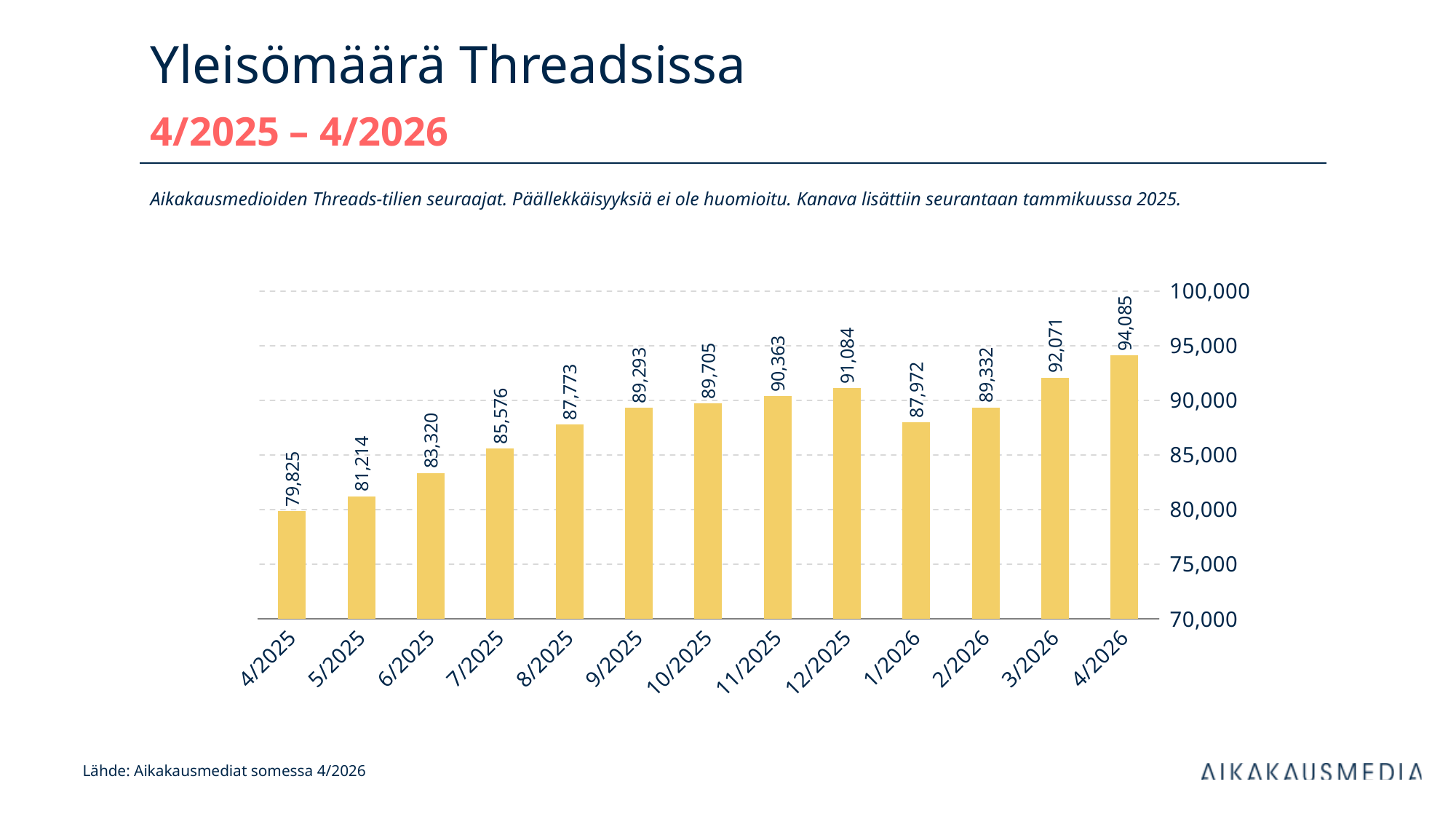
What is the difference between the values for 4/2026 and 4/2025? 14,260 What is the value for 1/2026? 87,972 How many months are shown on the x axis? 13 Which is larger, the value for 10/2025 or the value for 1/2026? 10/2025 Which month has the highest value? 4/2026 What is the value for 12/2025? 91,084 What kind of chart is shown on the slide? bar chart What is the value for 4/2025? 79,825 What is the difference between the values for 12/2025 and 1/2026? 3,112 What is the title of the slide? Yleisömäärä Threadsissa Is the value for 7/2025 greater or less than 85,000? greater Which month has the lowest value? 4/2025